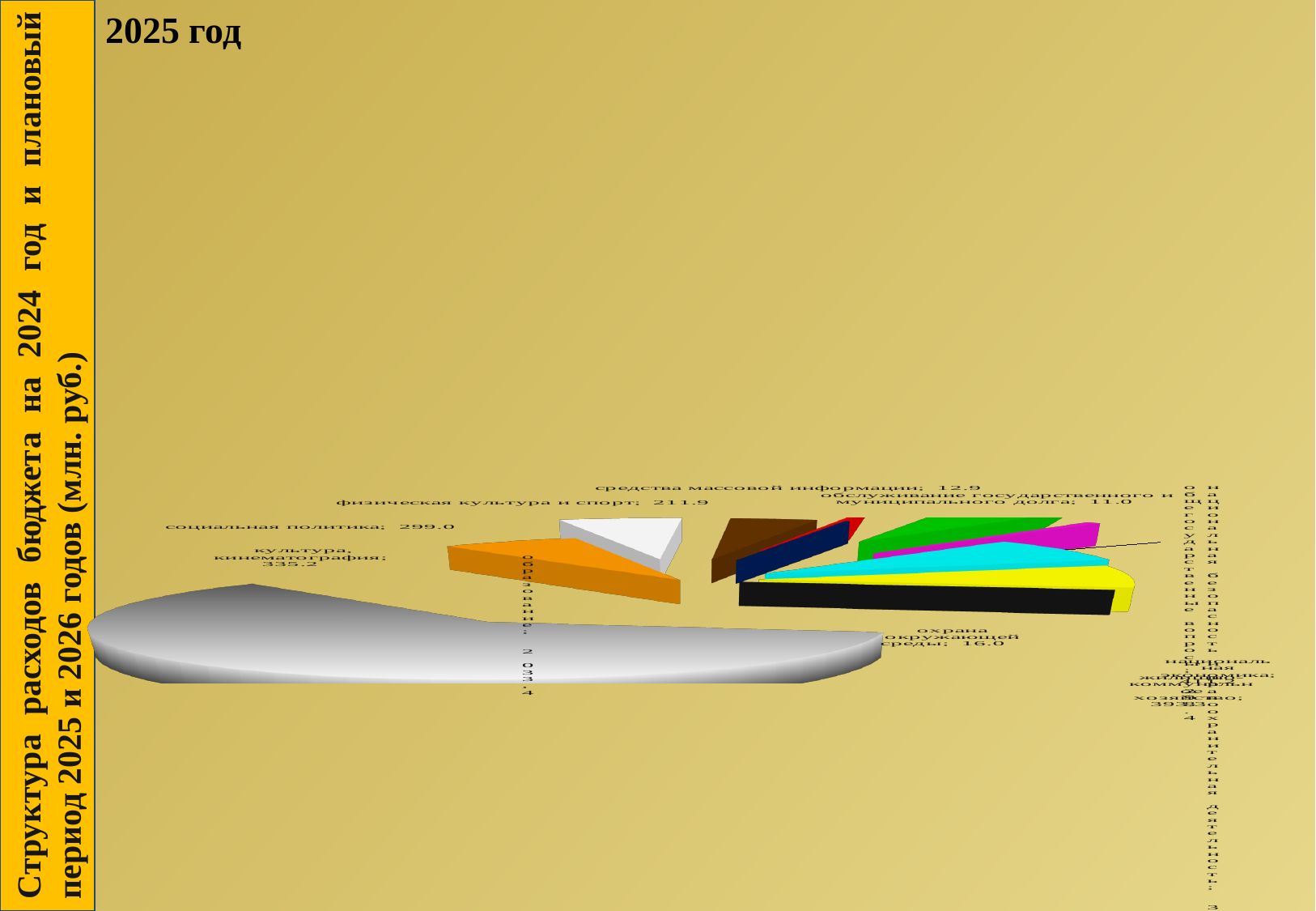
What is the difference between the values for социальная политика and физическая культура и спорт? 87.1 What is the title shown above the chart? 2025 год What is the value for образование? 2033.4 Which is larger, социальная политика or физическая культура и спорт? социальная политика What is the value for социальная политика? 299.0 What is the value for охрана окружающей среды? 16.0 What is the value for культура, кинематография? 335.2 What kind of chart is shown on the slide? pie chart What is the value for физическая культура и спорт? 211.9 Which category has the largest slice of the pie? образование What is the value for обслуживание государственного и муниципального долга? 11.0 What is the value for средства массовой информации? 12.9